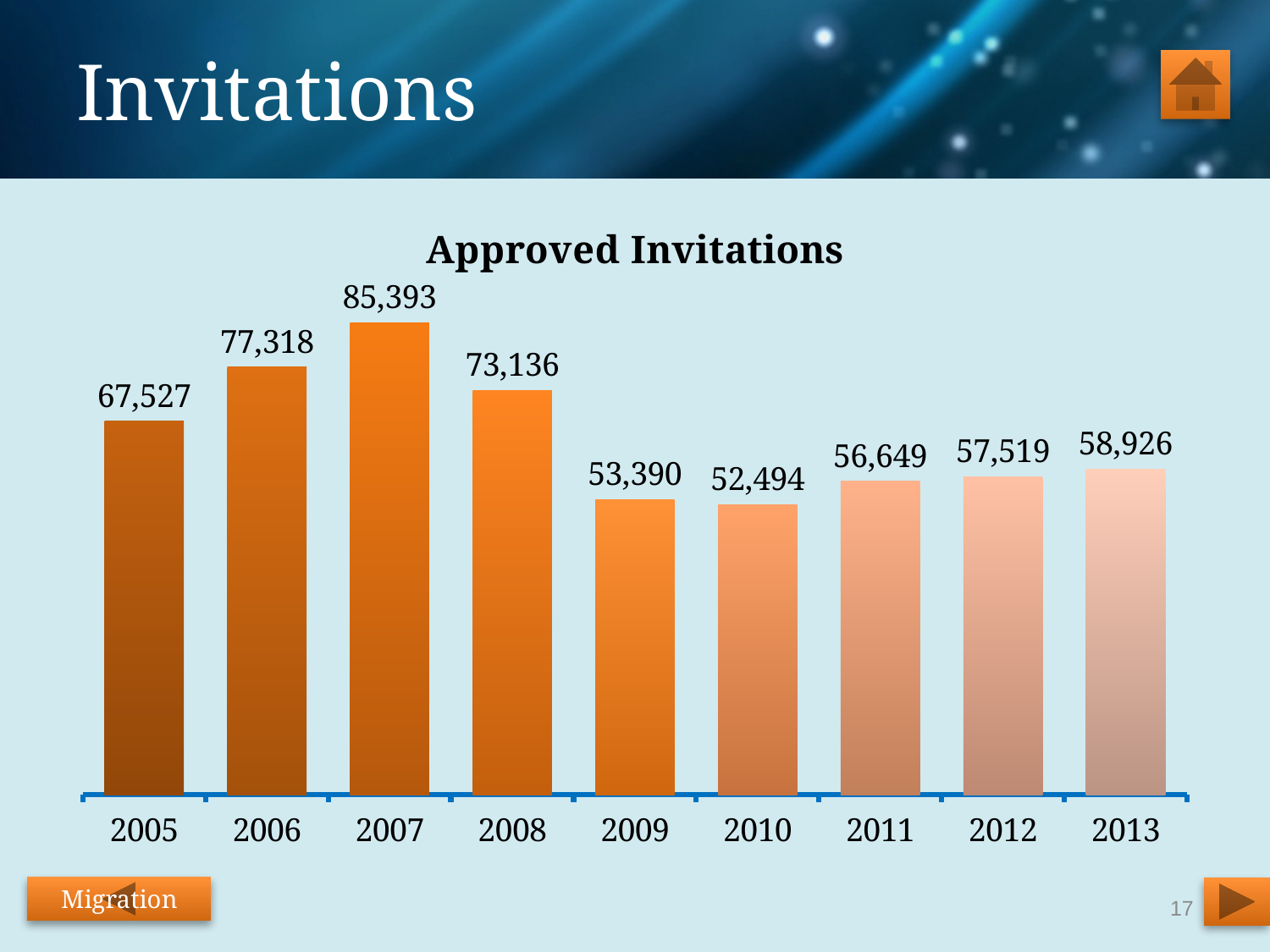
What kind of chart is shown on the slide? bar chart What is the value for 2010 in the Approved Invitations chart? 52,494 What is the title of the chart? Approved Invitations Which year has the highest number of approved invitations? 2007 What is the value for 2013 in the Approved Invitations chart? 58,926 What is the difference between the values for 2006 and 2005? 9,791 Which year has the lowest number of approved invitations? 2010 Do the values rise or fall from 2010 to 2013? rise What is the value for 2007 in the Approved Invitations chart? 85,393 Which is larger, the value for 2008 or the value for 2011? 2008 How many years are shown on the x axis of the chart? 9 What is the difference between the values for 2007 and 2010? 32,899